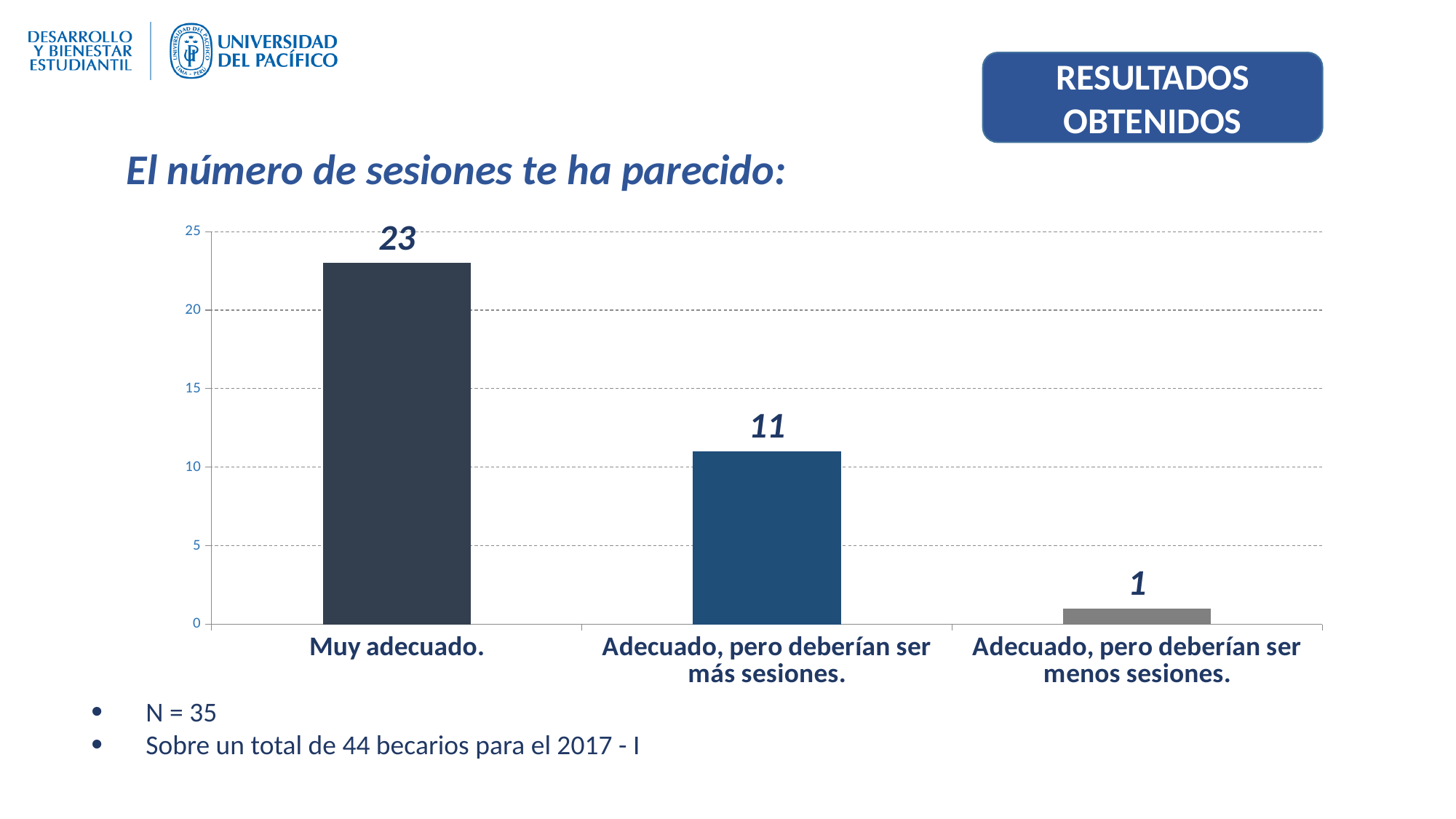
Is the value for "Muy adecuado." greater or less than 20? greater What is the title of the chart? El número de sesiones te ha parecido: What is the value for "Adecuado, pero deberían ser más sesiones."? 11 What is the difference between the values for "Muy adecuado." and "Adecuado, pero deberían ser más sesiones."? 12 How many categories are shown on the chart? 3 What is the value for "Adecuado, pero deberían ser menos sesiones."? 1 What kind of chart is shown on the slide? bar chart Which category has the highest value? Muy adecuado. What is the value for "Muy adecuado."? 23 Which is larger: the value for "Adecuado, pero deberían ser más sesiones." or for "Adecuado, pero deberían ser menos sesiones."? Adecuado, pero deberían ser más sesiones. Which category has the lowest value? Adecuado, pero deberían ser menos sesiones. Do the values rise or fall from left to right across the categories? fall